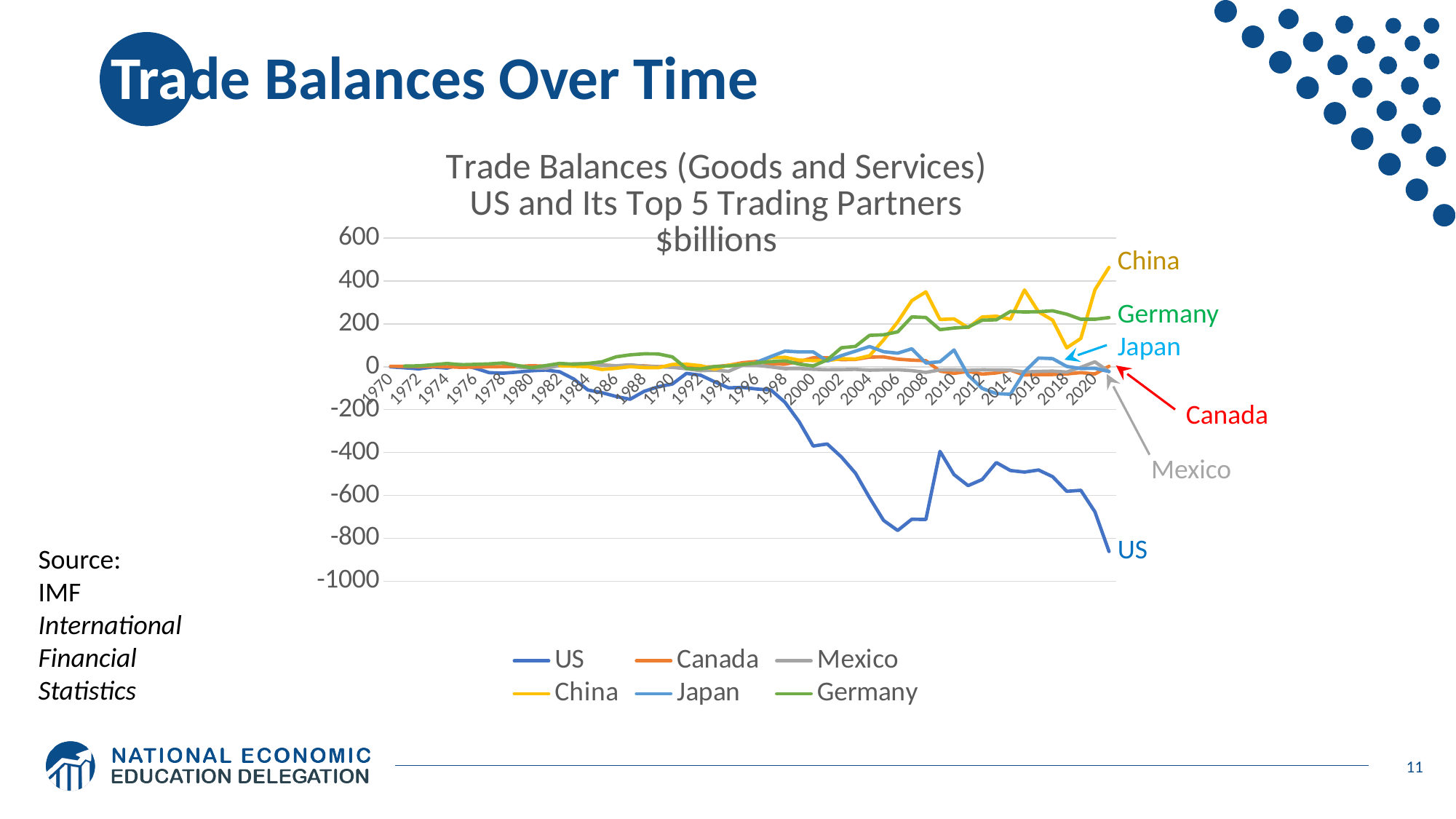
Is the value for China in 2020 greater or less than 400? less Is the value for Germany in 2020 greater or less than 200? greater Is the value for the US in 2006 greater or less than -600? less Which series has the highest value in 2020? China Which series is plotted in yellow? China In 2020, which is larger, the value for China or the value for Germany? China Does the US line rise or fall between 1998 and 2006? Fall What unit is stated in the chart title? $billions How many series does the legend list? 6 Which series has the lowest value in 2020? US What kind of chart is shown on the slide? Line chart